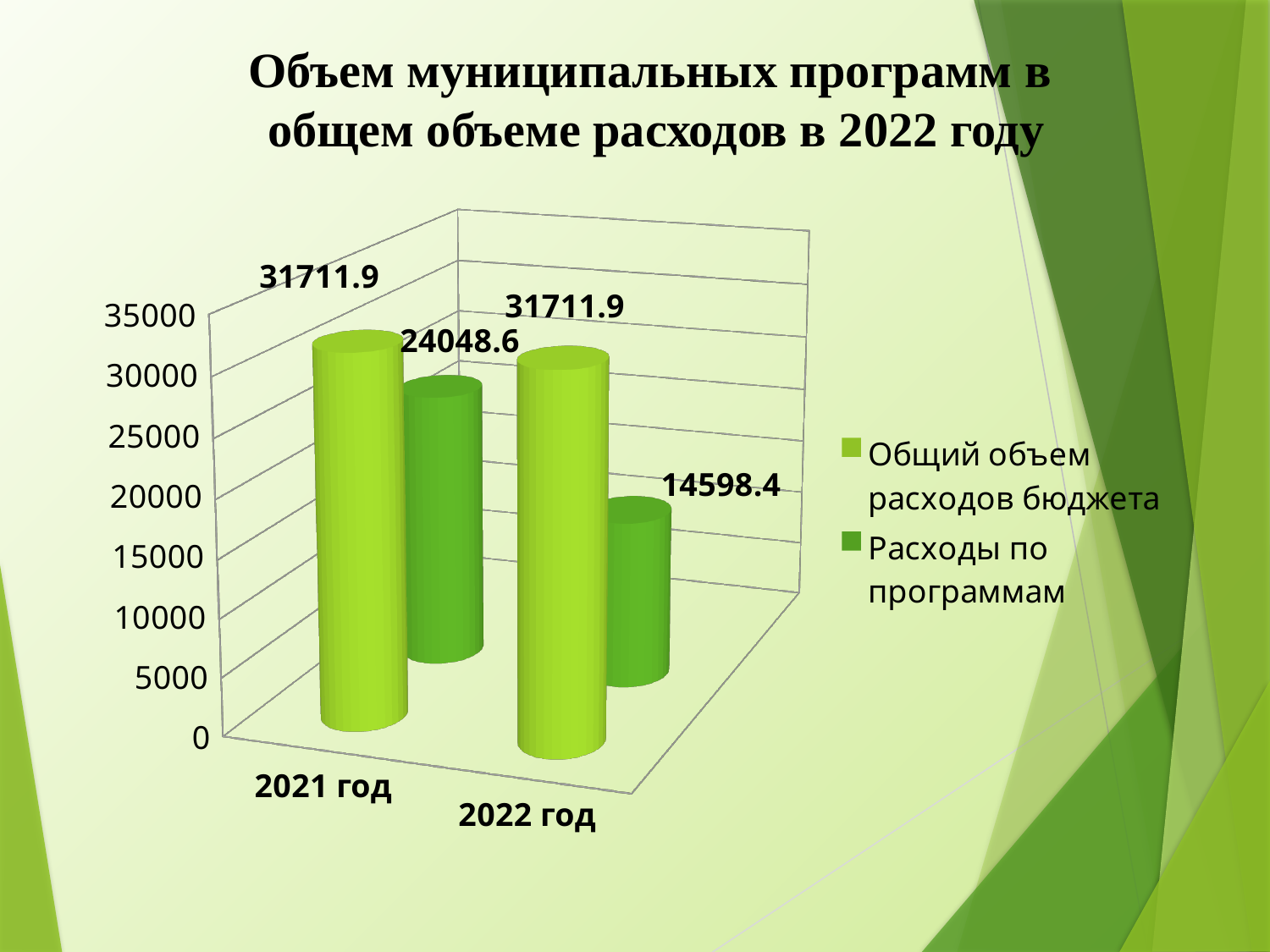
Does Расходы по программам rise or fall from 2021 год to 2022 год? Fall What is the difference between Общий объем расходов бюджета and Расходы по программам in 2022 год? 17113.5 How many series does the legend list? 2 What is the value of Расходы по программам for 2022 год? 14598.4 What kind of chart is shown on the slide? Bar chart What is the value of Расходы по программам for 2021 год? 24048.6 Which is larger in 2021 год: Общий объем расходов бюджета or Расходы по программам? Общий объем расходов бюджета What is the difference between Расходы по программам in 2021 год and 2022 год? 9450.2 What is the value of Общий объем расходов бюджета for 2021 год? 31711.9 What is the value of Общий объем расходов бюджета for 2022 год? 31711.9 How many categories are shown on the x axis? 2 In which year is Расходы по программам lowest? 2022 год